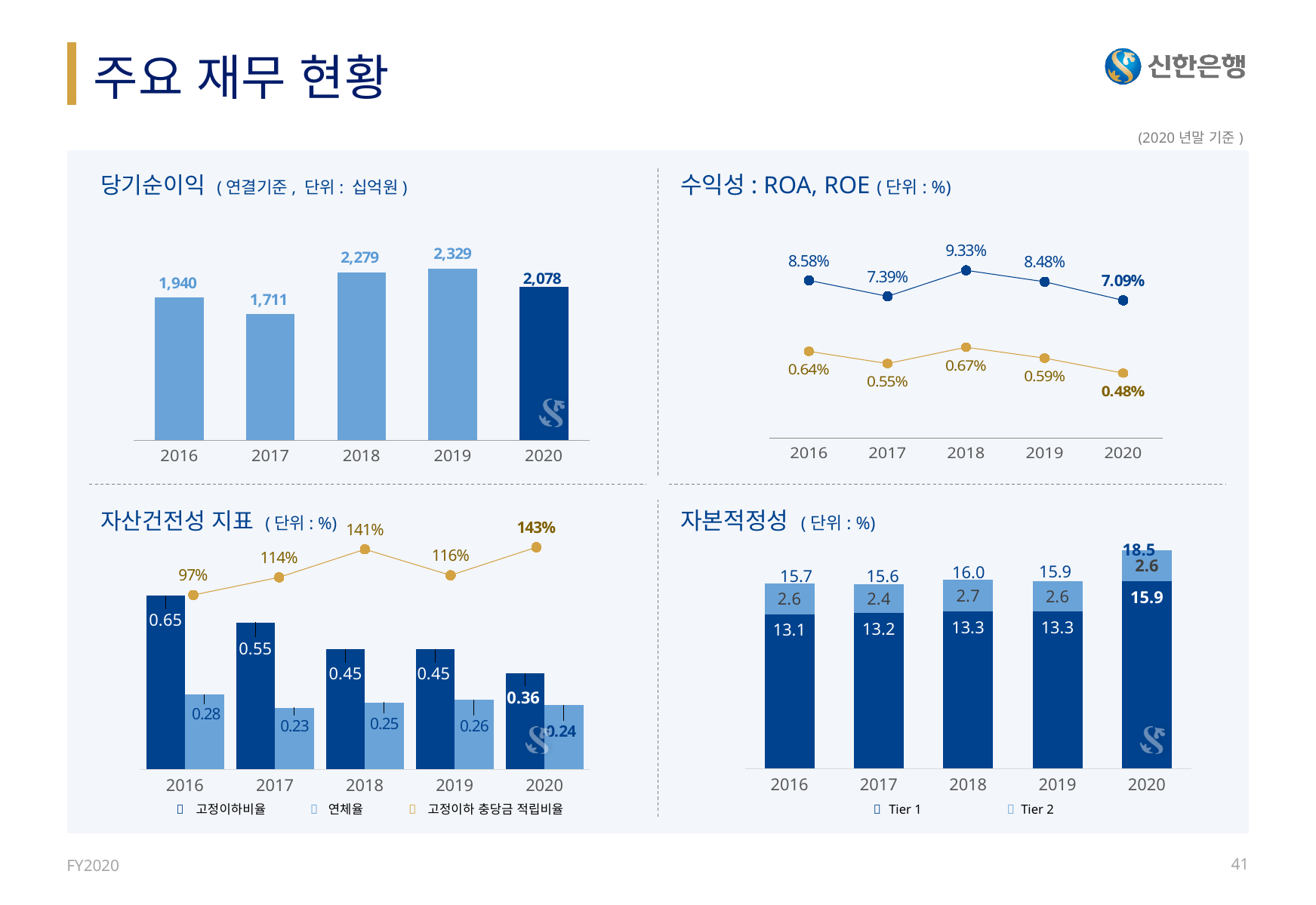
In the 수익성 : ROA, ROE chart (top right), what is the value of the upper (blue) line for 2018? 9.33% In the 자산건전성 지표 chart (bottom left), what is the 고정이하비율 value for 2020? 0.36 In the 자산건전성 지표 chart (bottom left), how many series does the legend list? 3 In the 수익성 : ROA, ROE chart (top right), what is the value of the lower (gold) line for 2020? 0.48% In the 당기순이익 chart (top left), which year has the lowest value? 2017 In the 자본적정성 chart (bottom right), what is the total of the stacked bar for 2020? 18.5 In the 당기순이익 chart (top left), what is the value for 2019? 2,329 In the 당기순이익 chart (top left), what is the difference between the 2019 and 2020 values? 251 In the 자본적정성 chart (bottom right), which is larger, the Tier 1 value for 2020 or the Tier 1 value for 2019? 2020 In the 수익성 : ROA, ROE chart (top right), what kind of chart is it? line chart In the 자산건전성 지표 chart (bottom left), which year has the highest 고정이하 충당금 적립비율? 2020 In the 당기순이익 chart (top left), how many years are shown on the x axis? 5